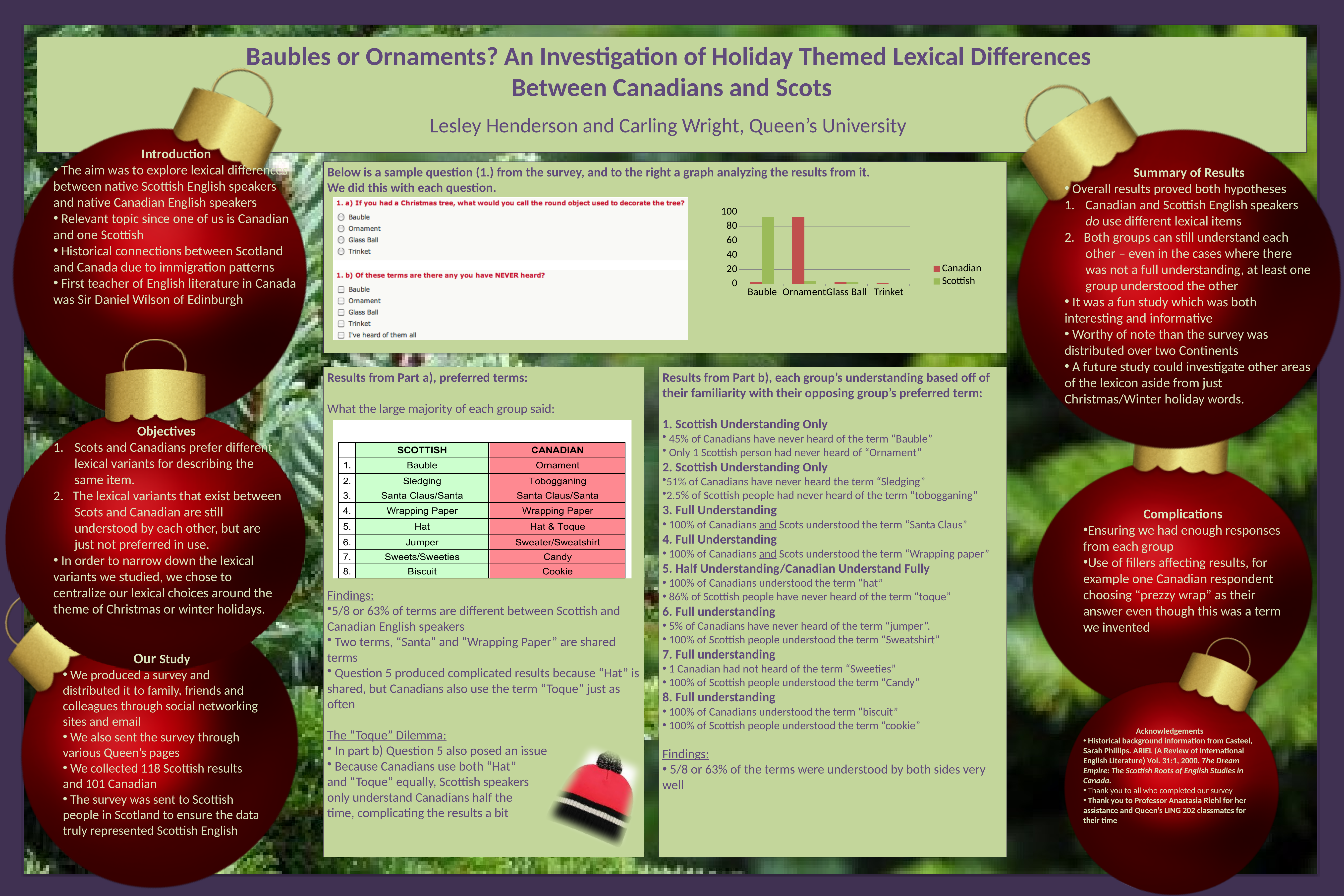
Is the Canadian value for Ornament greater or less than 80? greater For the Bauble category, which series has the larger value, Canadian or Scottish? Scottish Which category has the highest value for the Canadian series? Ornament What kind of chart is shown on the slide? bar chart Is the Scottish value for Bauble greater or less than 80? greater How many categories are shown on the x axis of the chart? 4 Which category has the highest value for the Scottish series? Bauble For the Ornament category, which series has the larger value, Canadian or Scottish? Canadian Is the Scottish value for Trinket greater or less than 20? less How many series does the chart's legend list? 2 Which colour represents the Canadian series in the chart's legend? red